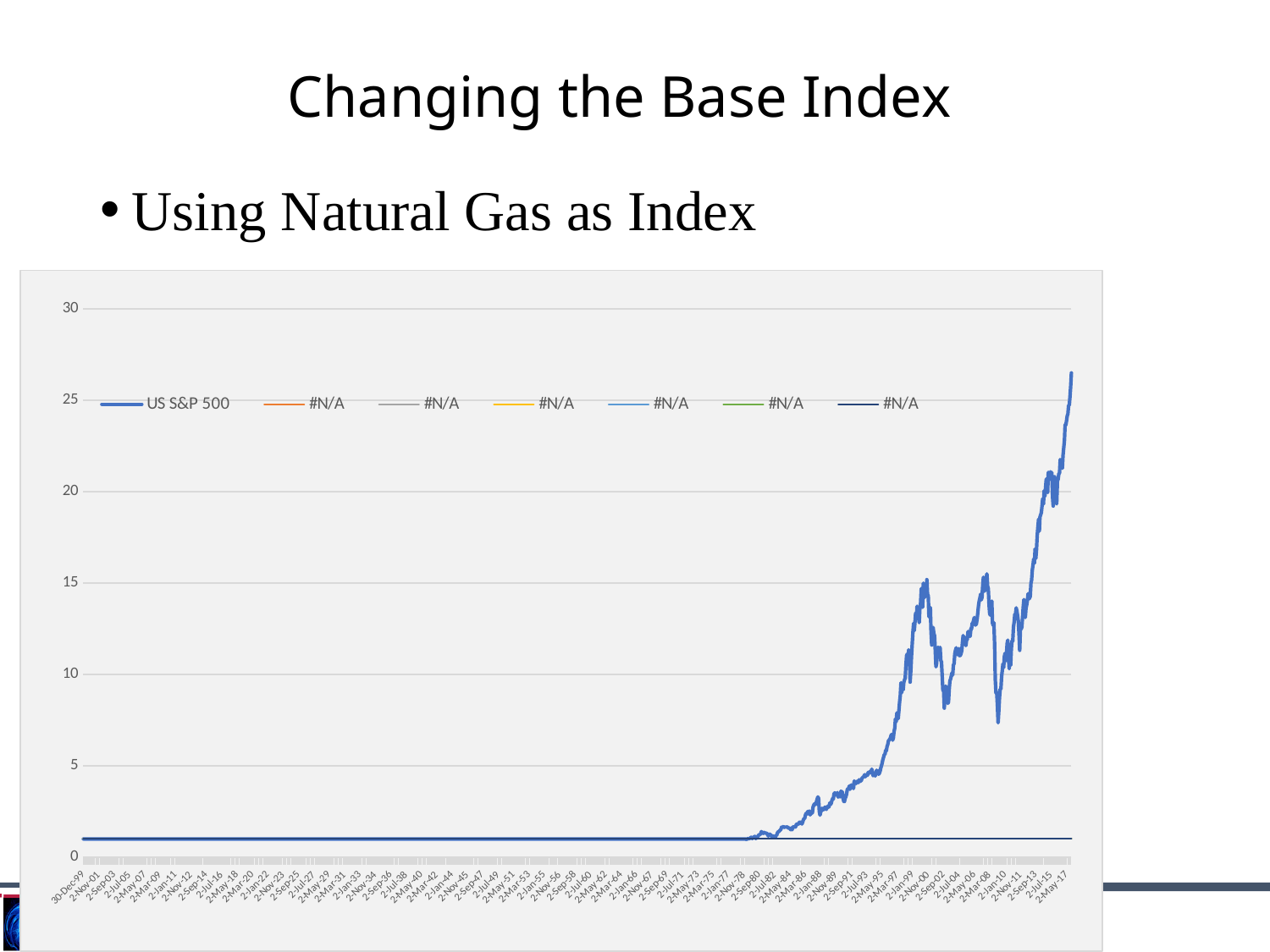
Is the value of the US S&P 500 line at the far right end of the chart greater or less than 20? greater Is the value of the US S&P 500 line at the far left of the chart greater or less than 5? less How many series does the chart's legend list? 7 Is the value of the US S&P 500 line at the far right end of the chart greater or less than 30? less What kind of chart is shown on the slide? line chart What is the name of the first series in the chart's legend? US S&P 500 How many legend entries are labelled #N/A? 6 Which is larger: the US S&P 500 value at the far left of the chart or at the far right of the chart? far right Overall, does the US S&P 500 line rise or fall from left to right across the chart? rise What is the first date label shown on the chart's horizontal axis? 30-Dec-99